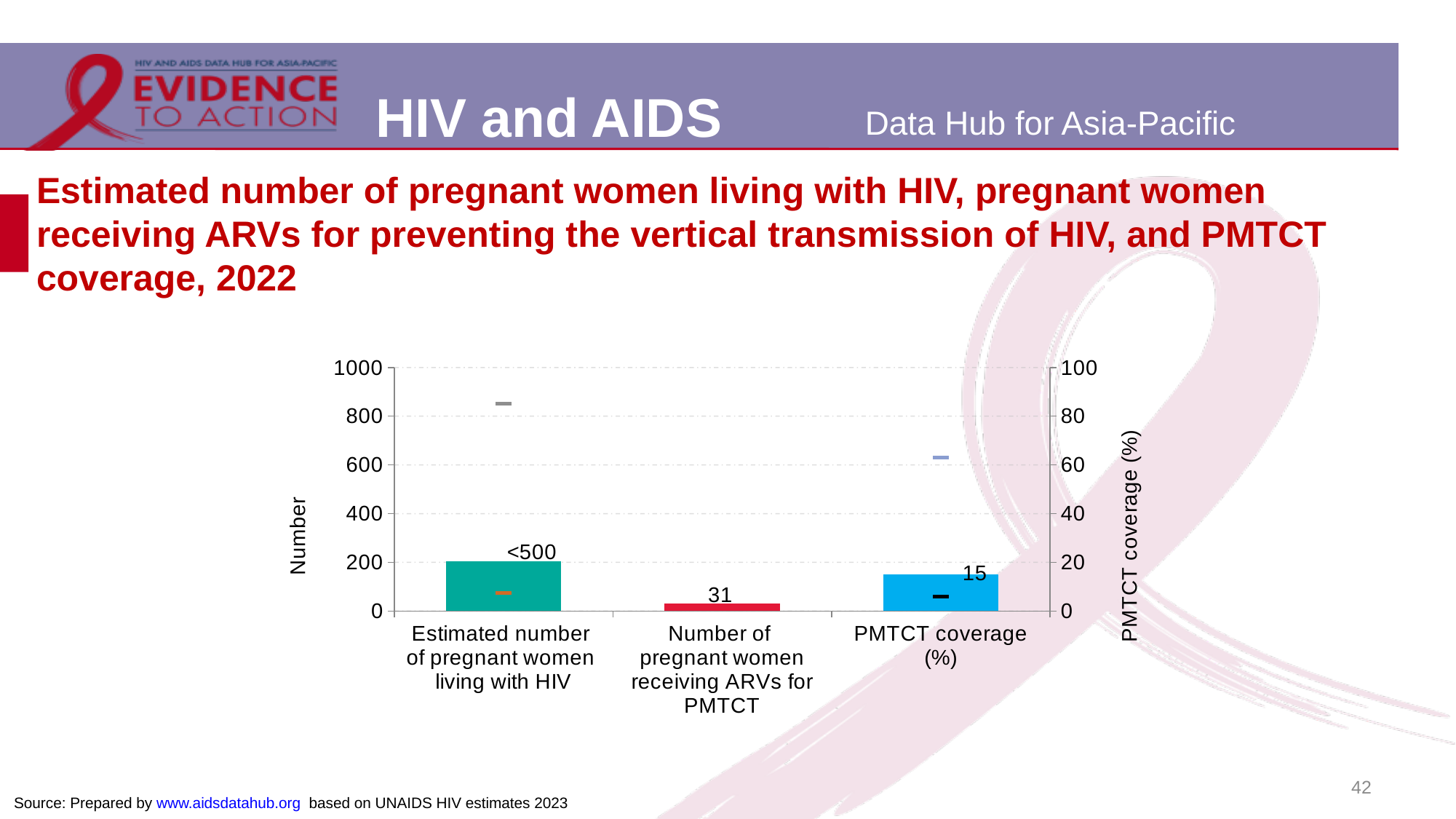
How many categories are plotted on the x axis of the chart? 3 Is the PMTCT coverage bar greater or less than 40 on the right axis? less What kind of chart is shown on the slide? Bar chart What is the number of pregnant women receiving ARVs for PMTCT shown on the chart? 31 What is the maximum value shown on the right vertical axis of the chart? 100 What is the PMTCT coverage (%) value shown on the chart? 15 What is the title of the left vertical axis of the chart? Number Is the bar for the estimated number of pregnant women living with HIV greater or less than 400 on the left axis? less Is the bar for the number of pregnant women receiving ARVs for PMTCT greater or less than 200 on the left axis? less Which year does the chart's data refer to, according to the slide title? 2022 What is the data label shown for the estimated number of pregnant women living with HIV? <500 What is the title of the right vertical axis of the chart? PMTCT coverage (%)